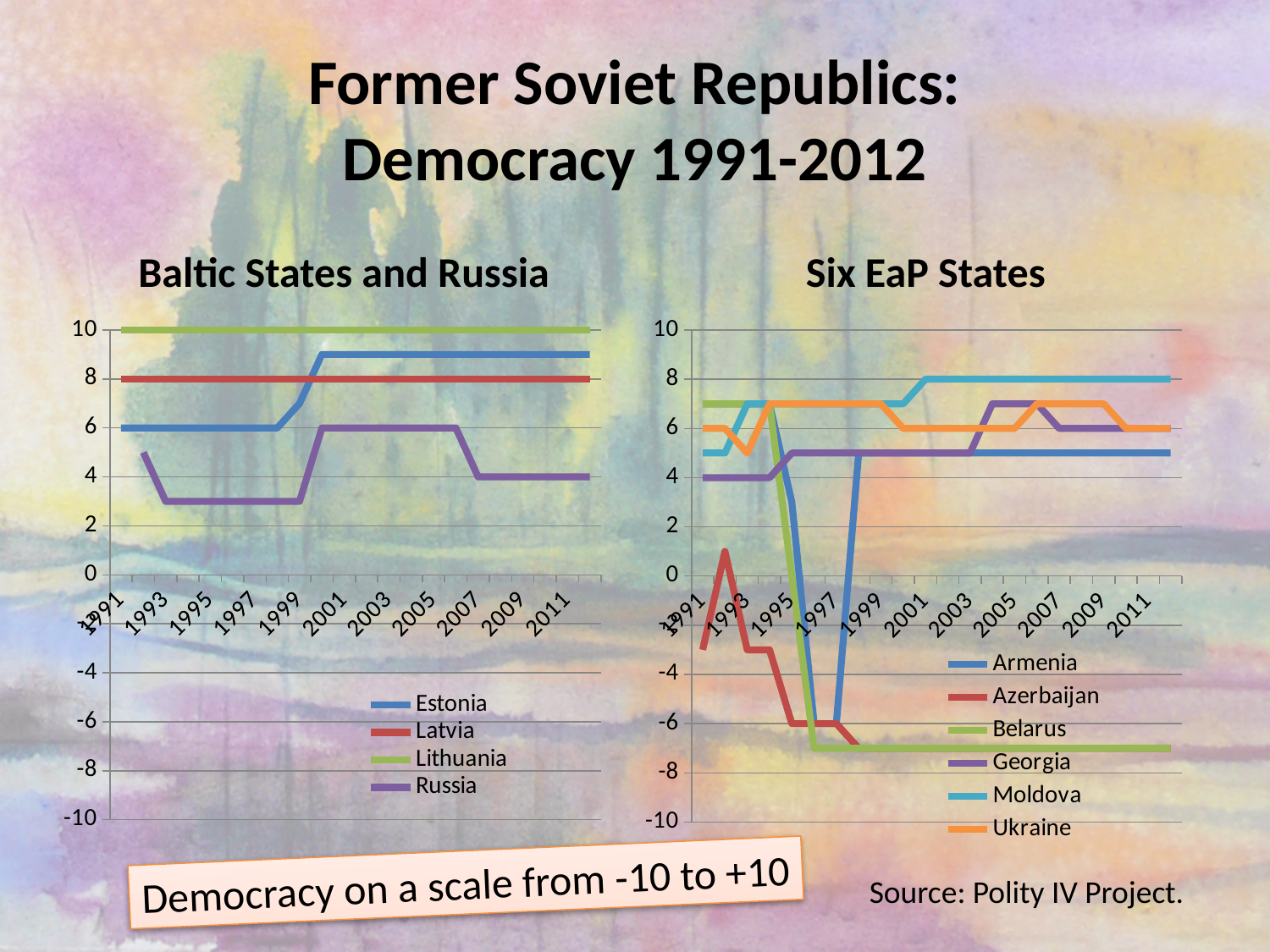
How many series does the legend of the 'Baltic States and Russia' chart list? 4 In the 'Six EaP States' chart, is the value for Belarus in 2011 greater or less than 0? less In the 'Baltic States and Russia' chart, what value does Lithuania hold throughout the whole period? 10 What kind of chart is the 'Baltic States and Russia' chart? line chart In the 'Six EaP States' chart, which country has the highest value in 2011? Moldova In the 'Six EaP States' chart, which country has the lowest value in 2011? Azerbaijan and Belarus (tied at -7) In the 'Baltic States and Russia' chart, which country has the highest value across the period? Lithuania In the 'Baltic States and Russia' chart, does Estonia's value rise or fall between 1991 and 2011? rise In the 'Baltic States and Russia' chart, what value does Latvia hold throughout the whole period? 8 In the 'Baltic States and Russia' chart, which is larger in 2011, Estonia or Russia? Estonia In the 'Baltic States and Russia' chart, which country has the lowest value in 2011? Russia How many series does the legend of the 'Six EaP States' chart list? 6